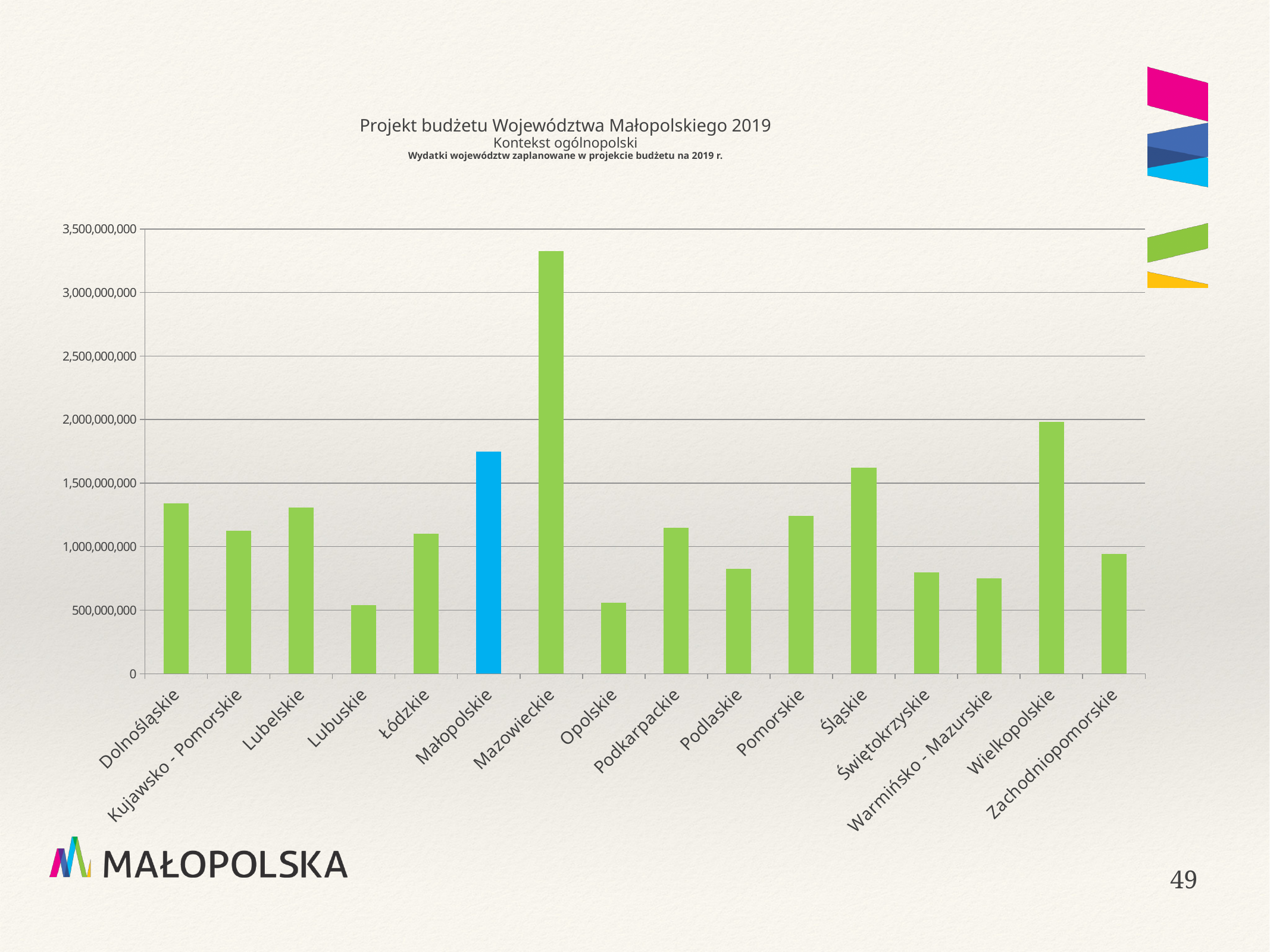
Is the value for Kujawsko - Pomorskie greater or less than 1,000,000,000? greater What kind of chart is shown on the slide? bar chart Which is larger, the value for Małopolskie or the value for Śląskie? Małopolskie Which voivodeship's bar is highlighted in blue instead of green? Małopolskie Is the value for Śląskie greater or less than 1,500,000,000? greater Is the value for Opolskie greater or less than 1,000,000,000? less How many voivodeships (categories) are plotted on the chart? 16 Which is larger, the value for Mazowieckie or the value for Wielkopolskie? Mazowieckie Which voivodeship has the highest planned expenditure in the chart? Mazowieckie